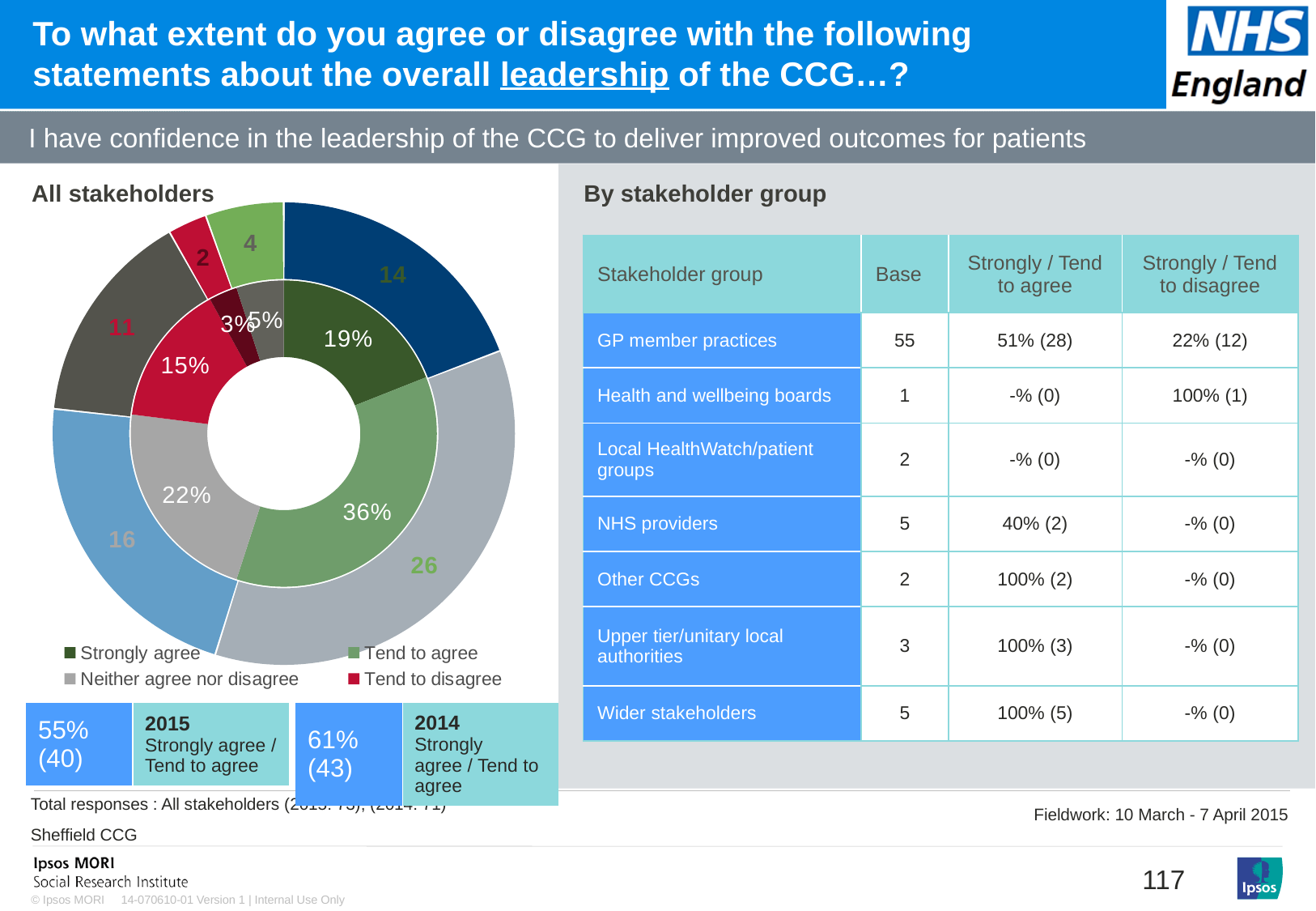
In the All stakeholders chart, what colour represents Tend to disagree in the legend? Red In the All stakeholders chart, what is the difference in percentage points between Tend to agree and Strongly agree? 17 In the All stakeholders chart, which response category has the largest share? Tend to agree In the All stakeholders chart, what is the combined percentage of Strongly agree and Tend to agree? 55% How many entries does the legend of the All stakeholders chart list? 4 In the All stakeholders chart, what number is shown on the outer ring for the Tend to agree segment? 26 What type of chart is used for All stakeholders? Doughnut (pie) chart In the All stakeholders chart, what percentage is shown for Strongly agree? 19% In the All stakeholders chart, what percentage is shown for Tend to agree? 36% In the All stakeholders chart, which is larger: Neither agree nor disagree or Tend to disagree? Neither agree nor disagree In the All stakeholders chart, what percentage is shown for Neither agree nor disagree? 22% In the All stakeholders chart, what percentage is shown for Tend to disagree? 15%